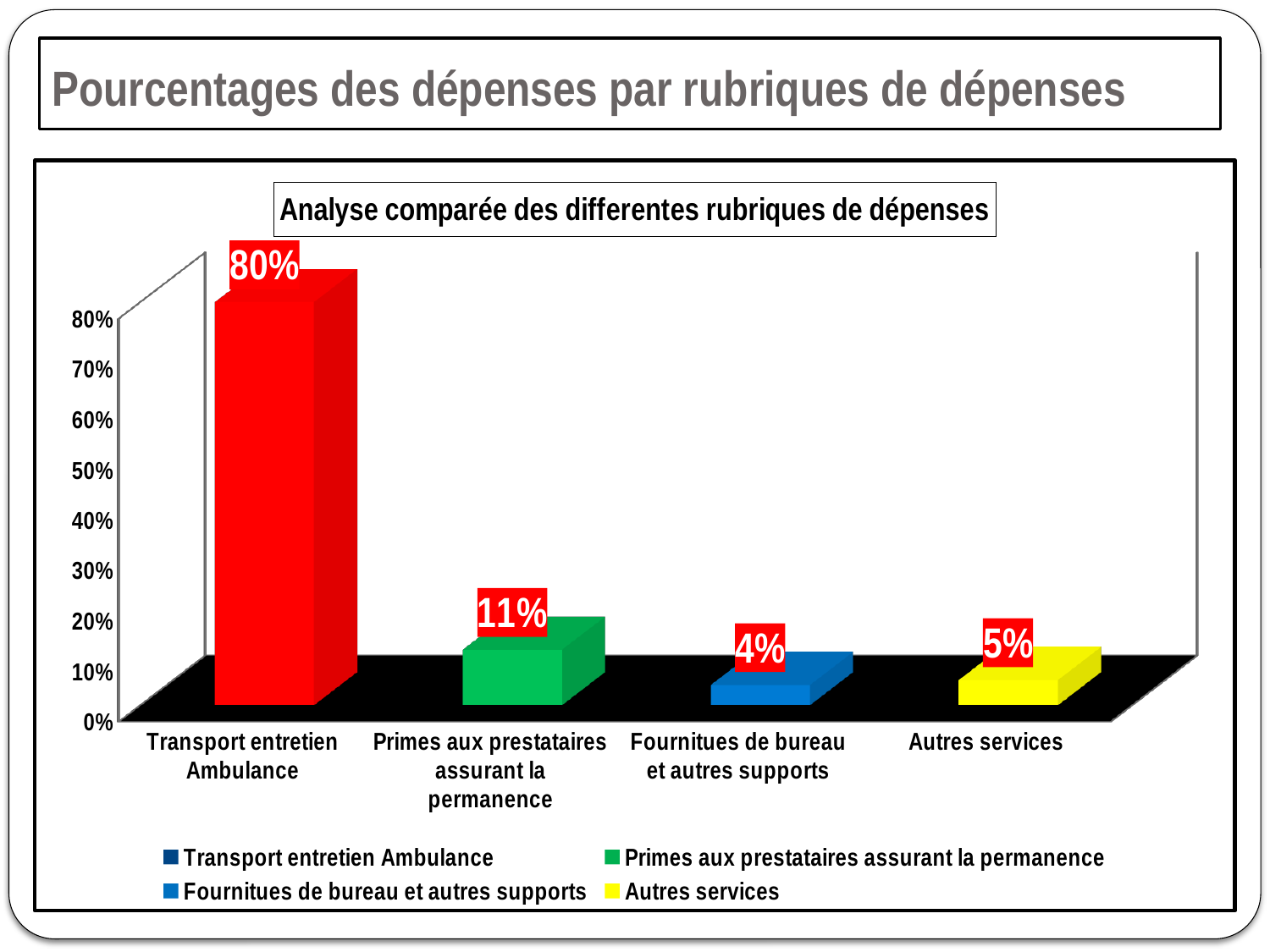
What is the value for Autres services? 5% What is the title of the chart? Analyse comparée des differentes rubriques de dépenses How many categories are shown on the x axis? 4 How many entries does the legend list? 4 What kind of chart is shown? bar chart What is the value for Primes aux prestataires assurant la permanence? 11% Which is larger, the value for Autres services or the value for Fournitues de bureau et autres supports? Autres services Which category has the lowest value? Fournitues de bureau et autres supports Which category has the highest value? Transport entretien Ambulance What is the value for Transport entretien Ambulance? 80% What is the value for Fournitues de bureau et autres supports? 4% What is the difference between the values for Transport entretien Ambulance and Primes aux prestataires assurant la permanence? 69%